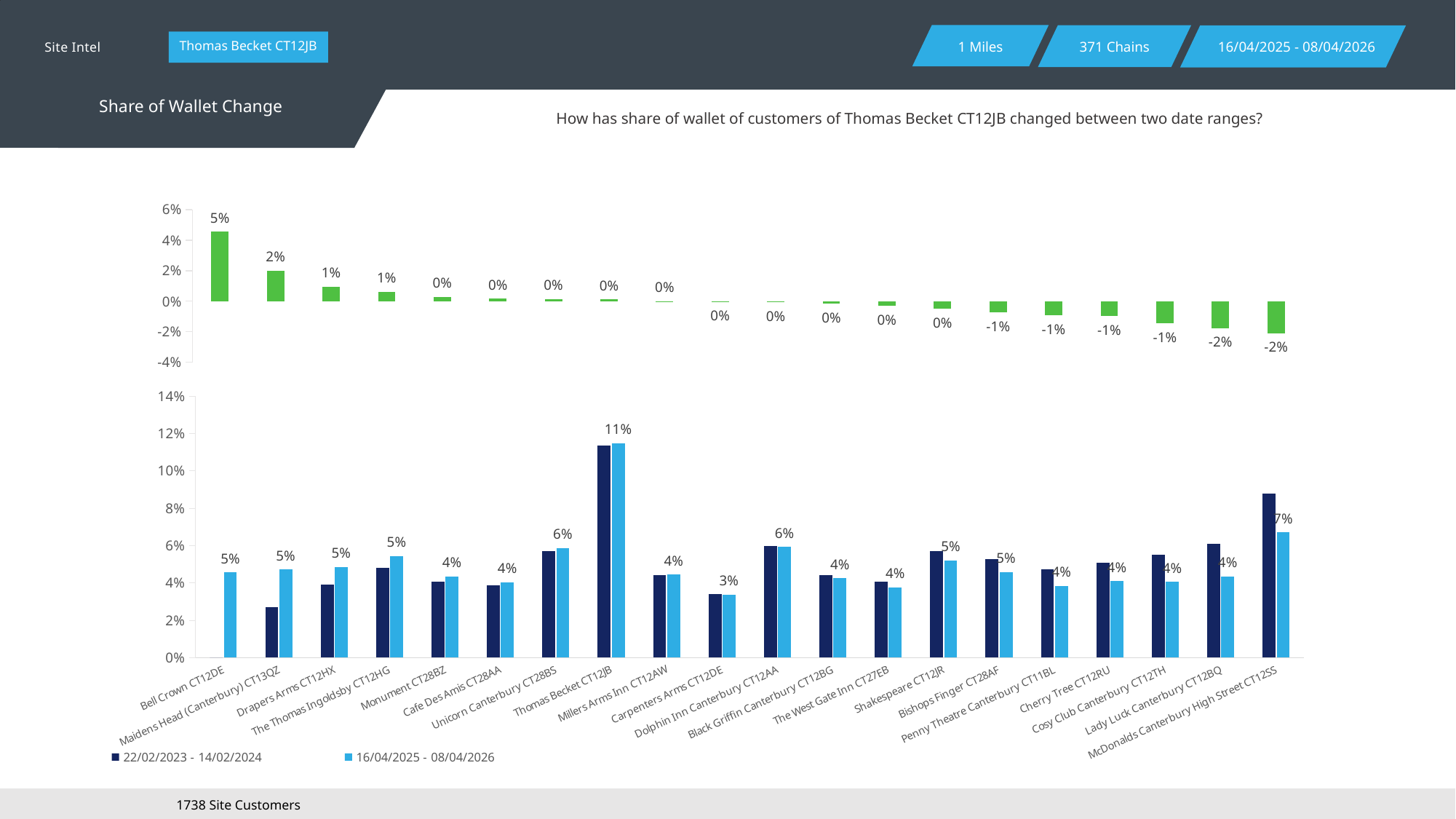
How many series does the legend of the bottom chart list? 2 In the bottom chart, is the 22/02/2023 - 14/02/2024 value for McDonalds Canterbury High Street CT12SS greater or less than 8%? greater In the top chart, which category has the highest share of wallet change? Bell Crown CT12DE In the top chart, what is the share of wallet change for Bell Crown CT12DE? 5% In the bottom chart, what is the labelled value for Thomas Becket CT12JB in the 16/04/2025 - 08/04/2026 series? 11% In the top chart, what is the share of wallet change for McDonalds Canterbury High Street CT12SS? -2% How many categories are shown on the x axis of the bottom chart? 20 In the top chart, do the share of wallet change values rise or fall from left to right along the x axis? fall In the bottom chart, which is larger in the 22/02/2023 - 14/02/2024 series: Thomas Becket CT12JB or McDonalds Canterbury High Street CT12SS? Thomas Becket CT12JB In the bottom chart, what is the difference between the labelled 16/04/2025 - 08/04/2026 values for Thomas Becket CT12JB and Carpenters Arms CT12DE? 8% In the bottom chart, which category has the highest share of wallet? Thomas Becket CT12JB What kind of chart is the bottom chart on the slide? bar chart